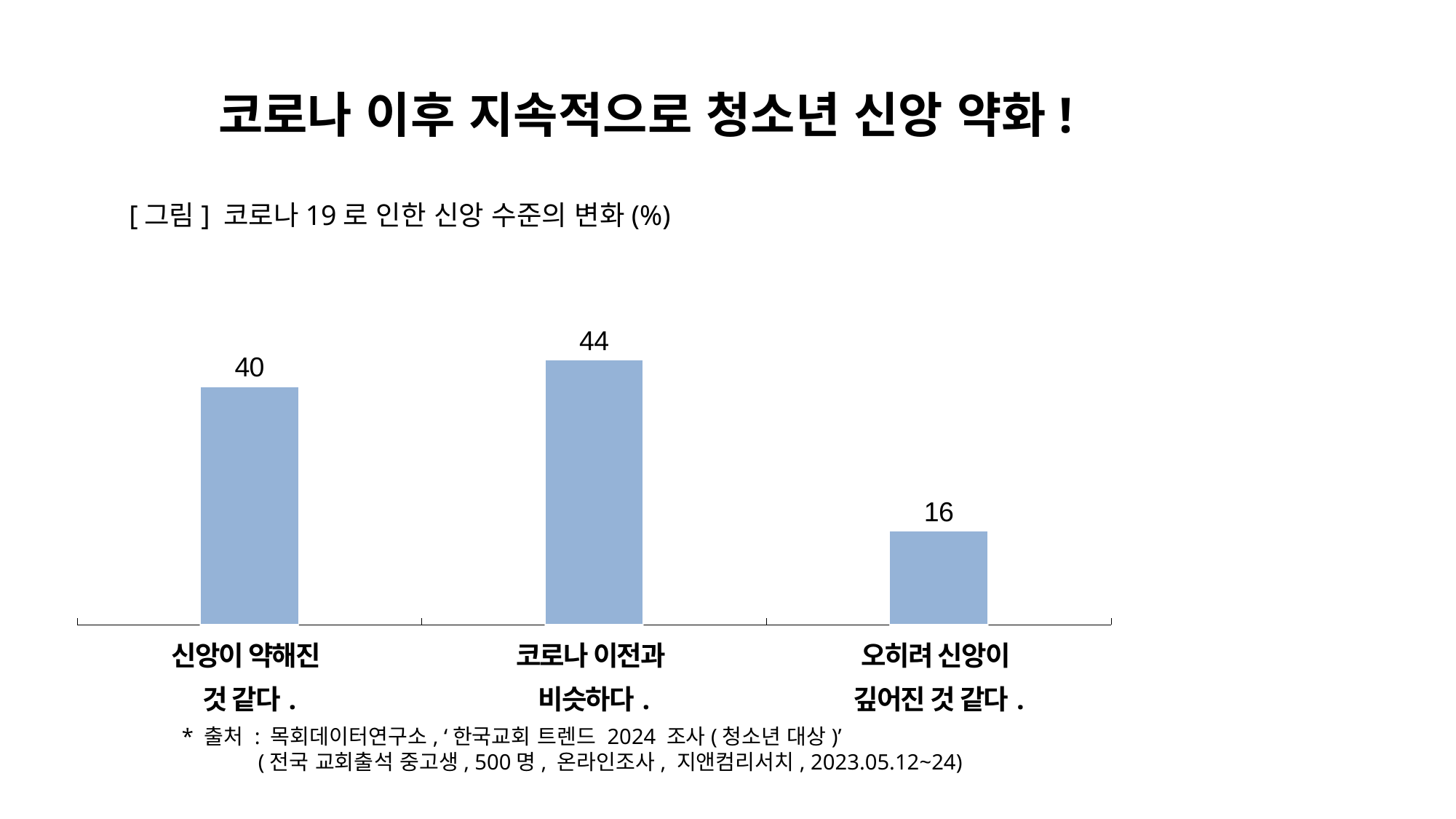
Which category has the highest value? 코로나 이전과 비슷하다. What kind of chart is shown on the slide? Bar chart How many categories are shown in the chart? 3 What is the value for '오히려 신앙이 깊어진 것 같다.'? 16 Which category has the lowest value? 오히려 신앙이 깊어진 것 같다. What is the value for '신앙이 약해진 것 같다.'? 40 What is the value for '코로나 이전과 비슷하다.'? 44 What is the difference between the values for '신앙이 약해진 것 같다.' and '오히려 신앙이 깊어진 것 같다.'? 24 What colour are the bars in the chart? Light blue What is the difference between the values for '코로나 이전과 비슷하다.' and '신앙이 약해진 것 같다.'? 4 Which is larger, the value for '신앙이 약해진 것 같다.' or the value for '오히려 신앙이 깊어진 것 같다.'? 신앙이 약해진 것 같다. What is the caption of the chart? [그림] 코로나 19로 인한 신앙 수준의 변화(%)